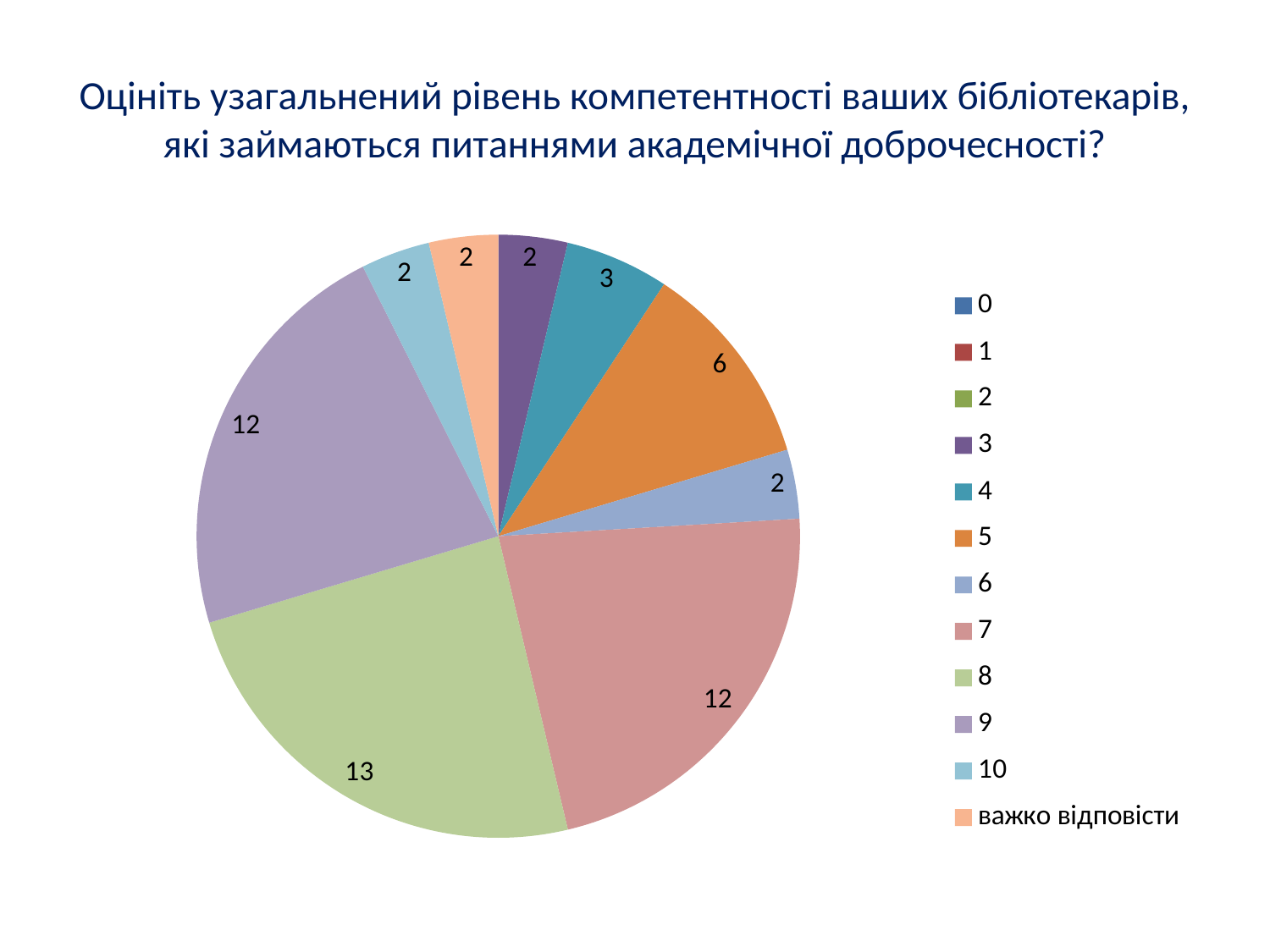
What value is shown for the slice labelled 5? 6 How many entries does the legend list? 12 What value is shown for the slice 'важко відповісти'? 2 What value is shown for the slice labelled 4? 3 Which category has the largest slice in the pie chart? 8 What kind of chart is shown on the slide? pie chart What is the last entry in the legend? важко відповісти Which is larger, the value for 5 or the value for 4? 5 What is the difference between the values for 8 and 5? 7 Which is larger, the value for 9 or the value for 6? 9 What value is shown for the slice labelled 8? 13 What is the difference between the values for 7 and 10? 10